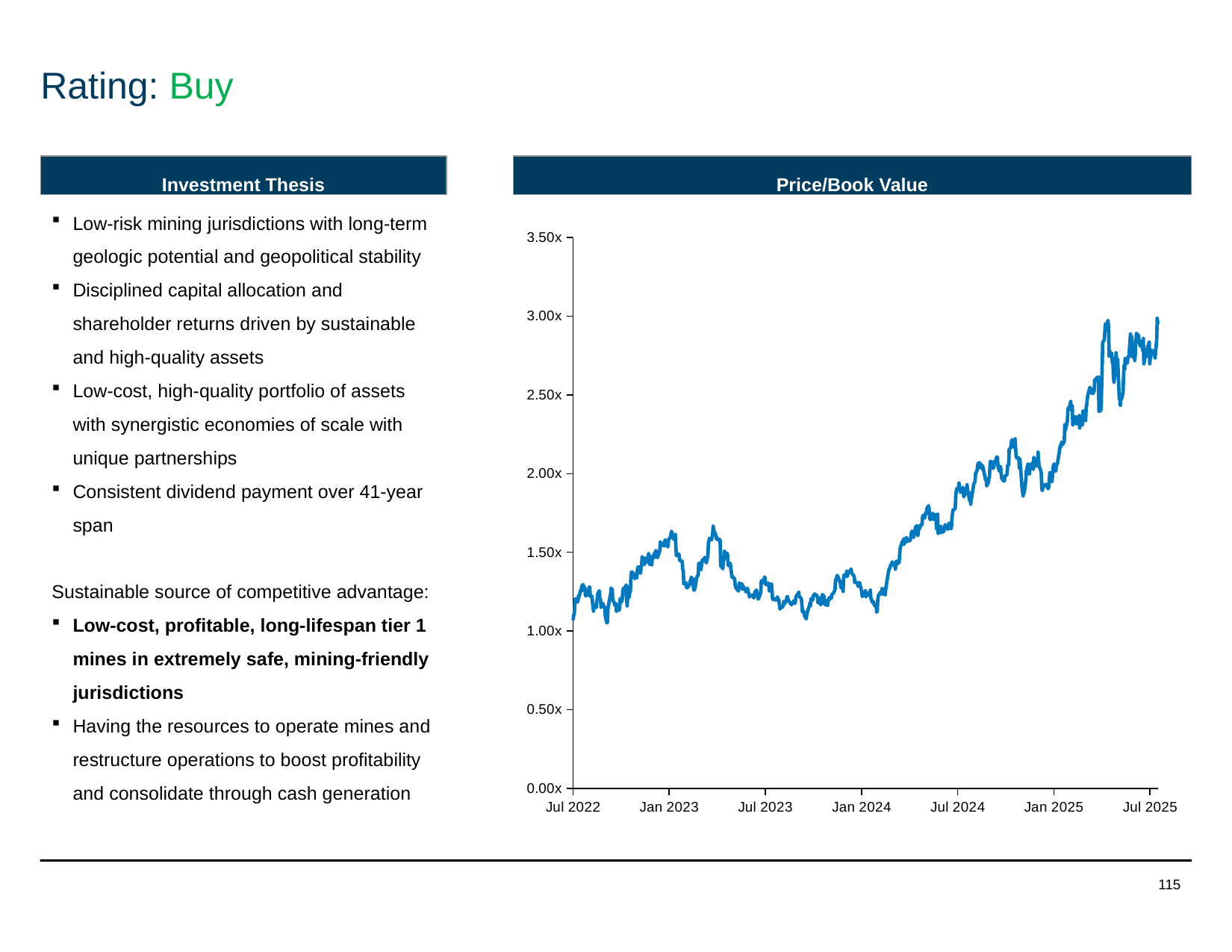
Is the Price/Book Value at Jul 2024 greater or less than 1.50x? greater What kind of chart is shown on the slide? line chart Is the Price/Book Value at Jan 2025 greater or less than 2.50x? less Is the Price/Book Value at Jan 2023 greater or less than 1.00x? greater Which is larger, the Price/Book Value at Jul 2025 or at Jul 2022? Jul 2025 What is the highest value shown on the y axis? 3.50x Overall, does the Price/Book Value line rise or fall from Jul 2022 to Jul 2025? rise How many date labels are shown on the x axis? 7 What is the title of the chart? Price/Book Value